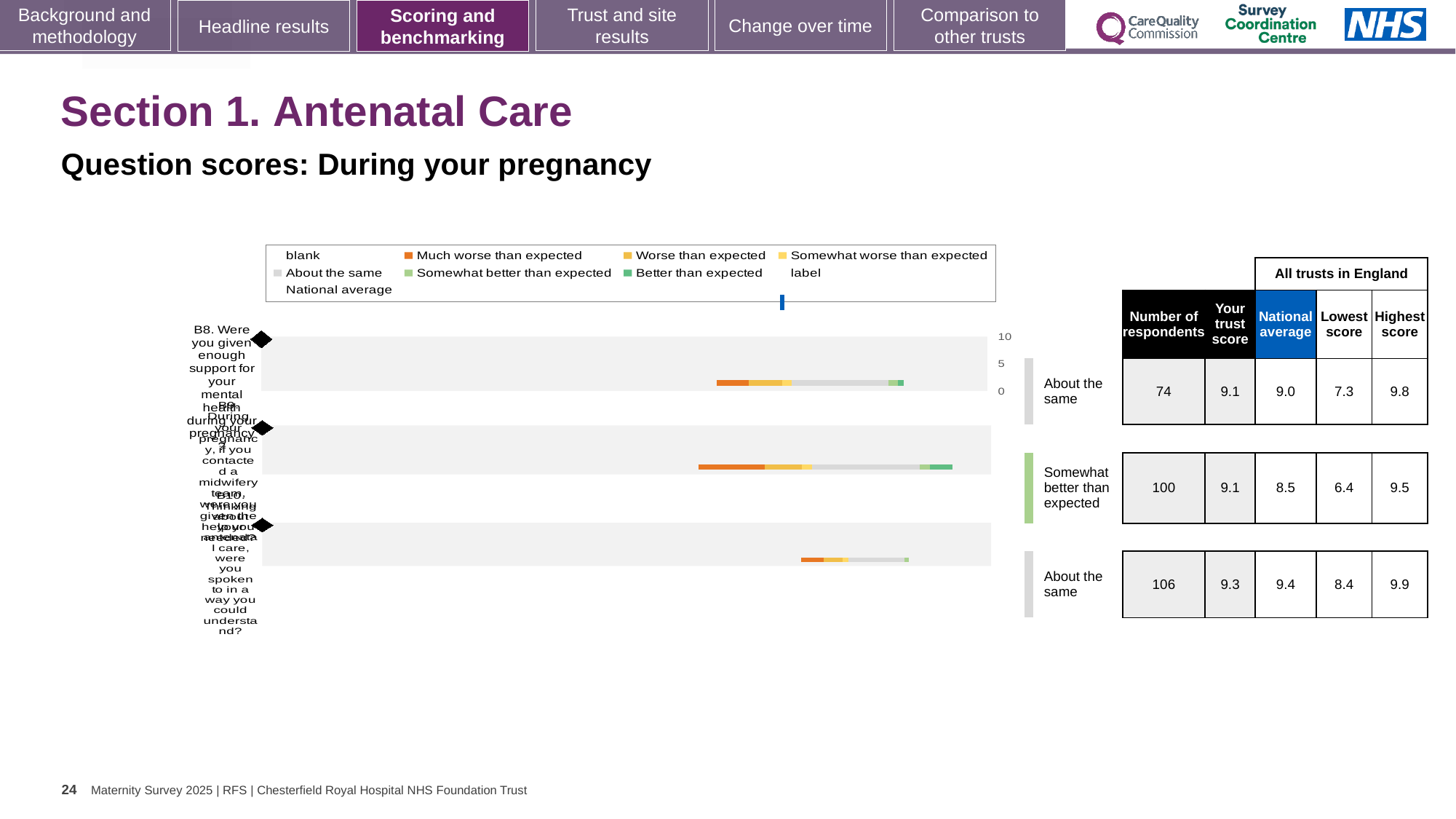
Which row of the table has the lowest 'Lowest score' value? the second row (6.4) In the table, what is the national average for the first row? 9.0 Which row of the table has the highest number of respondents? the third row (106) For the second row of the table, what is the difference between the highest score and the lowest score? 3.1 What colour does the legend use for 'Much worse than expected'? orange How many question bars are plotted in the chart? 3 What benchmark rating is shown for the first row of the table? About the same For the second row of the table, which is larger: the trust score or the national average? the trust score (9.1) In the table, what is the number of respondents for the second row (rated 'Somewhat better than expected')? 100 For the third row of the table, how much higher is the national average than the trust score? 0.1 What kind of chart is shown on the slide? bar chart In the table, what is the trust score for the third row? 9.3